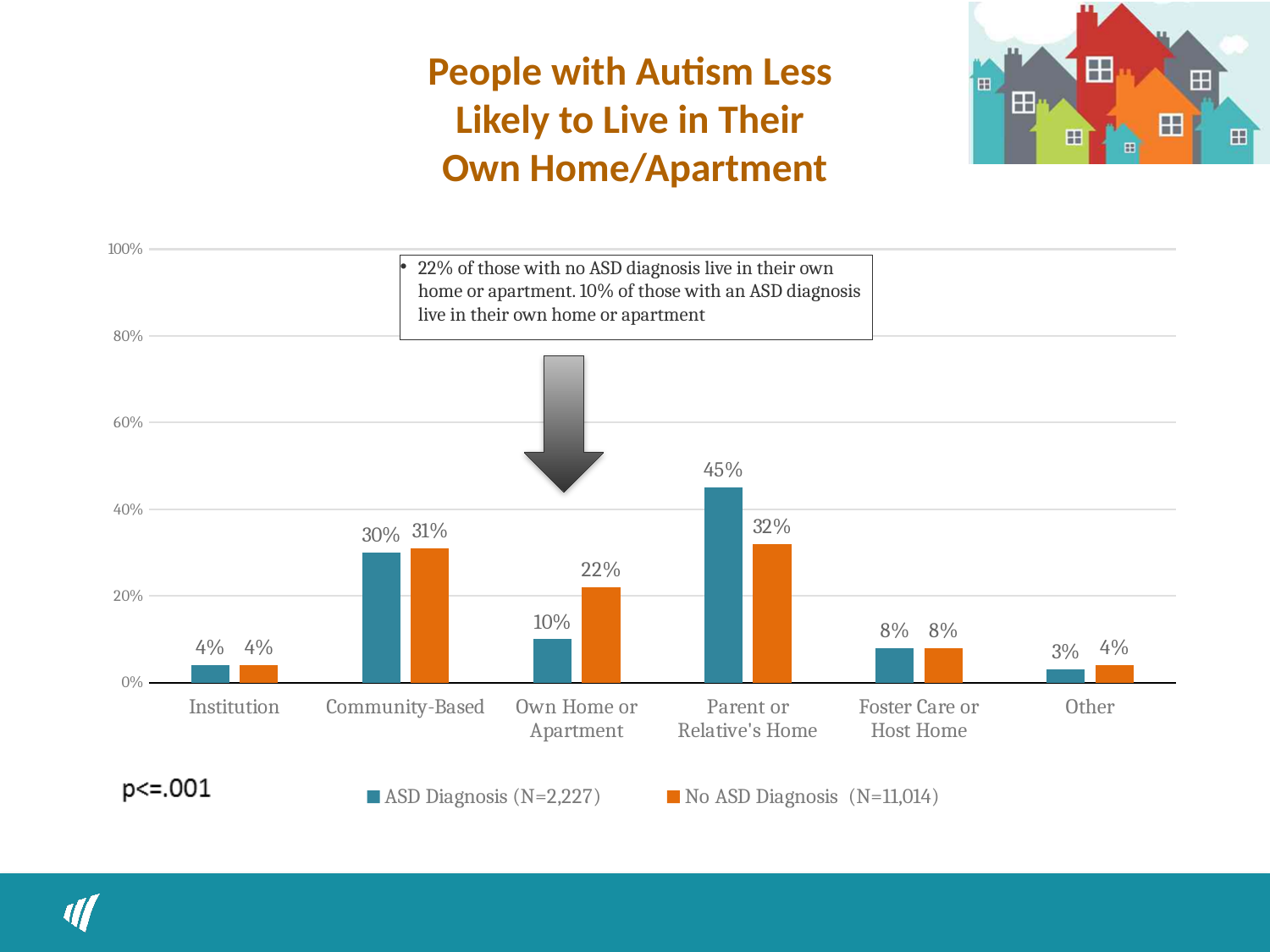
Which living arrangement has the lowest value for the ASD Diagnosis series? Other How many series does the legend list? 2 What percentage of people with an ASD diagnosis live in their own home or apartment? 10% What is the value for Community-Based for the No ASD Diagnosis series? 31% What kind of chart is shown on the slide? Bar chart What is the difference between the No ASD Diagnosis and ASD Diagnosis values for Own Home or Apartment? 12% What percentage of people with no ASD diagnosis live in a parent or relative's home? 32% What is the sample size (N) for the ASD Diagnosis series shown in the legend? 2,227 How many living arrangement categories are shown on the x axis? 6 For Own Home or Apartment, which series has the larger value? No ASD Diagnosis Which living arrangement has the highest value for the ASD Diagnosis series? Parent or Relative's Home What is the difference between the ASD Diagnosis and No ASD Diagnosis values for Parent or Relative's Home? 13%